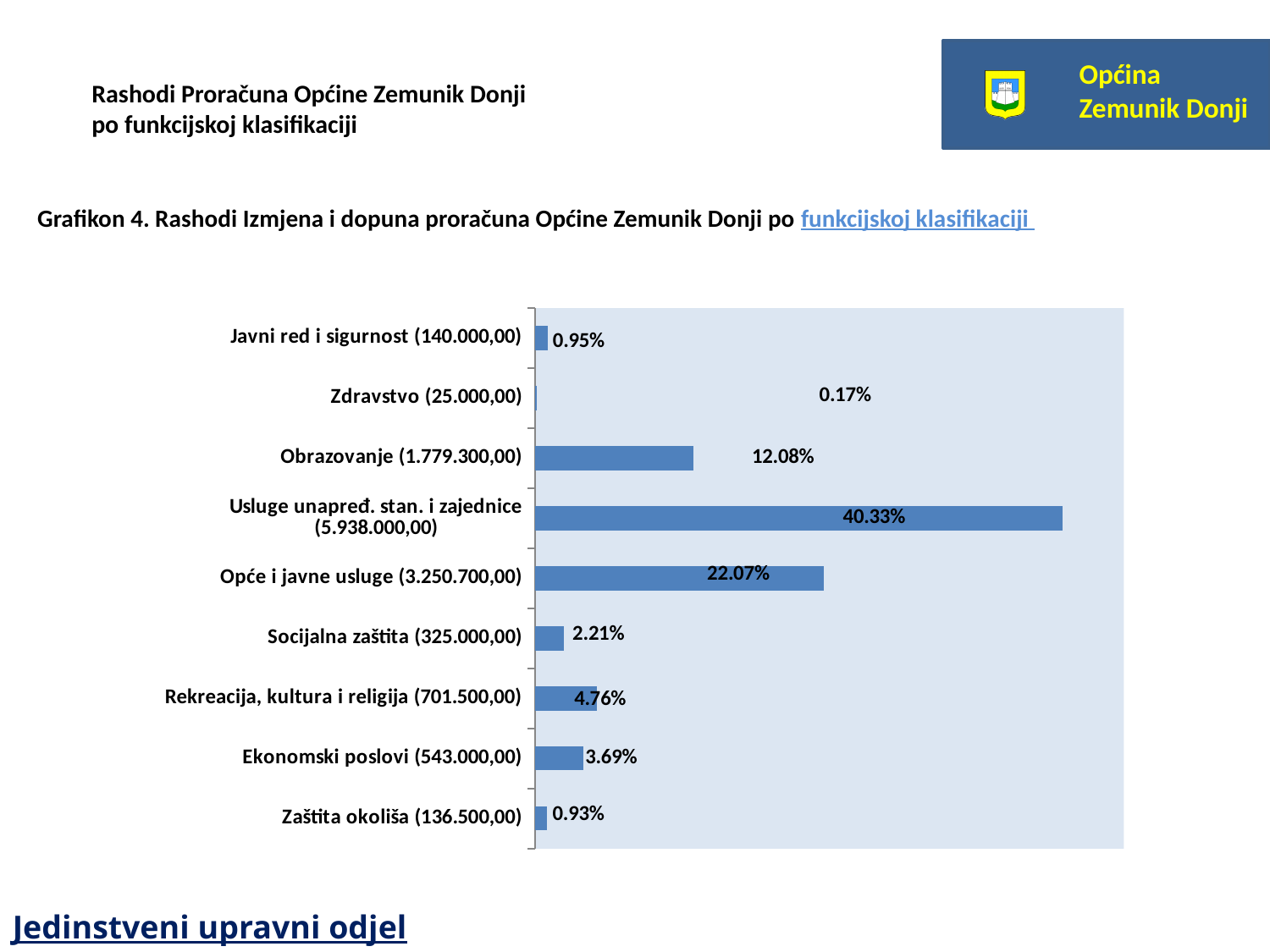
Which is larger, the value for Ekonomski poslovi or the value for Socijalna zaštita? Ekonomski poslovi What is the value for Zdravstvo (25.000,00)? 0.17% What percentage is shown for Obrazovanje (1.779.300,00)? 12.08% What is the value labelled for Opće i javne usluge (3.250.700,00)? 22.07% Which category has the smallest share in the chart? Zdravstvo (25.000,00) How many categories are plotted in the chart? 9 What is the difference in percentage points between Usluge unapređ. stan. i zajednice and Opće i javne usluge? 18.26% Which category has the largest share in the chart? Usluge unapređ. stan. i zajednice (5.938.000,00) What percentage is shown for Rekreacija, kultura i religija (701.500,00)? 4.76% What kind of chart is shown on the slide? Bar chart What is the difference between the values for Obrazovanje and Rekreacija, kultura i religija? 7.32% What is the title of the chart (Grafikon 4)? Rashodi Izmjena i dopuna proračuna Općine Zemunik Donji po funkcijskoj klasifikaciji